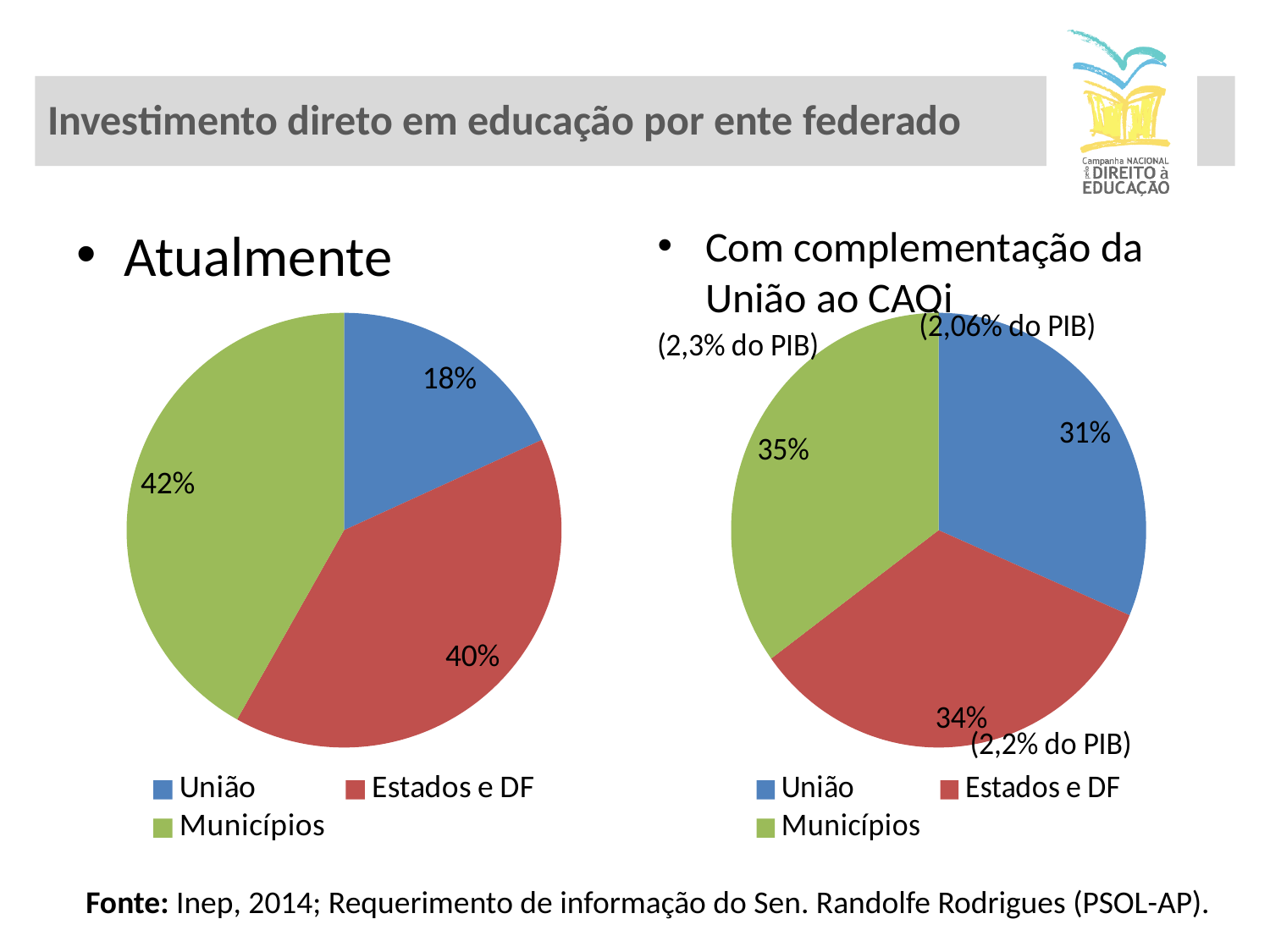
In the 'Atualmente' pie chart, what share do Municípios have? 42% In the 'Com complementação da União ao CAQi' pie chart, what share do Municípios have? 35% In the 'Atualmente' pie chart, what is the difference between the shares of Municípios and União? 24% What type of chart is used on the left side of the slide under 'Atualmente'? Pie chart In the 'Com complementação da União ao CAQi' pie chart, which is larger, the share of União or the share of Municípios? Municípios In the 'Atualmente' pie chart, what share does União have? 18% In the 'Com complementação da União ao CAQi' pie chart, what share does União have? 31% In the 'Com complementação da União ao CAQi' pie chart, what share do Estados e DF have? 34% In the 'Atualmente' pie chart, which category has the largest share? Municípios In the 'Atualmente' pie chart, what share do Estados e DF have? 40% In the 'Atualmente' pie chart, which category has the smallest share? União How many entries does the legend of the 'Atualmente' pie chart list? 3